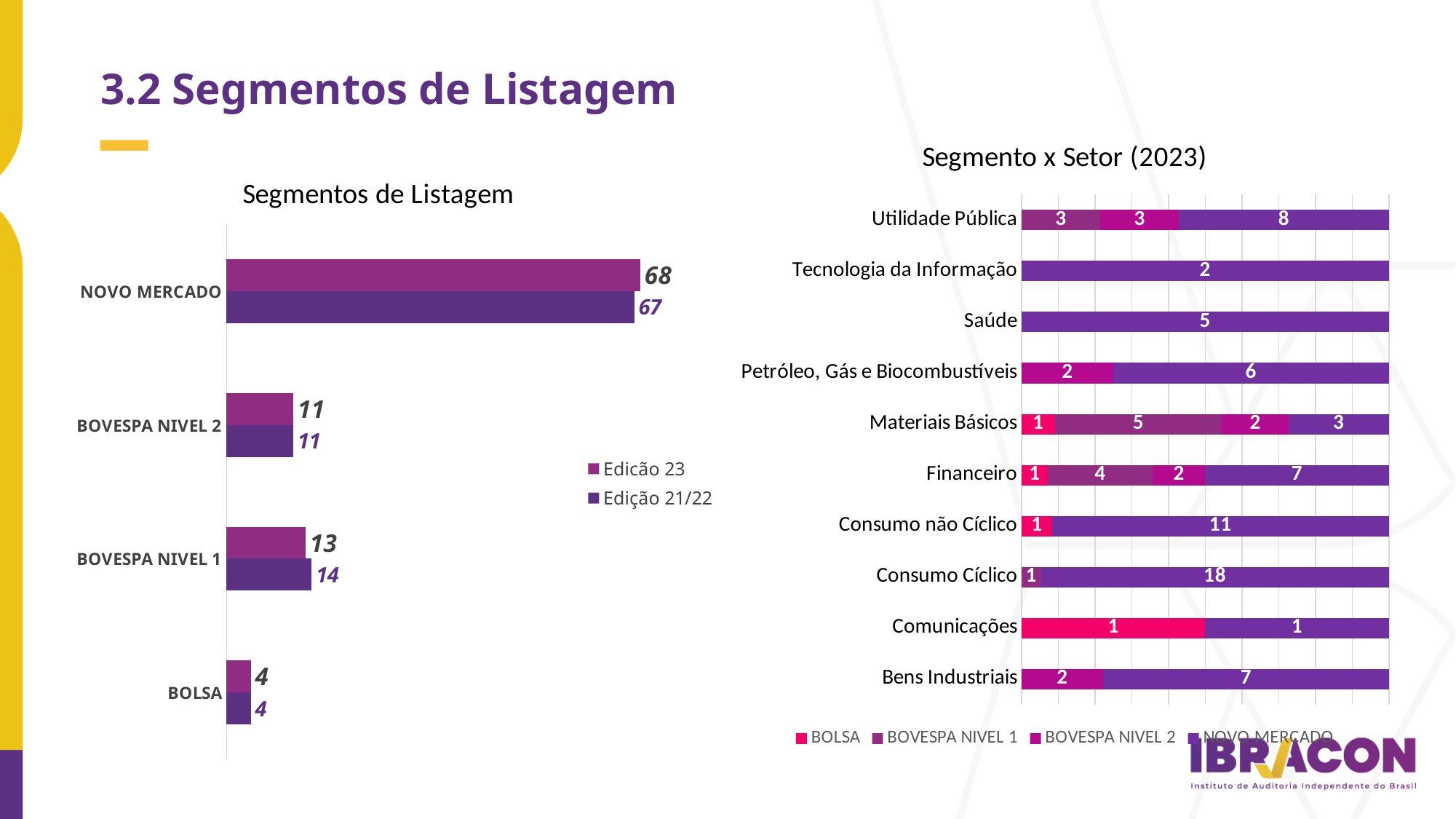
In the 'Segmentos de Listagem' chart, what is the value for NOVO MERCADO in the Edicão 23 series? 68 What kind of chart is the 'Segmento x Setor (2023)' chart? Stacked bar chart In the 'Segmentos de Listagem' chart, what is the value for BOVESPA NIVEL 1 in the Edição 21/22 series? 14 In the 'Segmentos de Listagem' chart, what is the difference between the Edicão 23 and Edição 21/22 values for NOVO MERCADO? 1 In the 'Segmentos de Listagem' chart, which category has the lowest value in the Edição 21/22 series? BOLSA In the 'Segmentos de Listagem' chart, how many series does the legend list? 2 In the 'Segmento x Setor (2023)' chart, what is the NOVO MERCADO value for Consumo Cíclico? 18 In the 'Segmento x Setor (2023)' chart, how many sector categories are shown? 10 In the 'Segmento x Setor (2023)' chart, what is the BOVESPA NIVEL 1 value for Materiais Básicos? 5 In the 'Segmento x Setor (2023)' chart, what is the total of the stacked bar for Financeiro? 14 In the 'Segmentos de Listagem' chart, which category has the highest value in the Edicão 23 series? NOVO MERCADO In the 'Segmento x Setor (2023)' chart, how many series does the legend list? 4